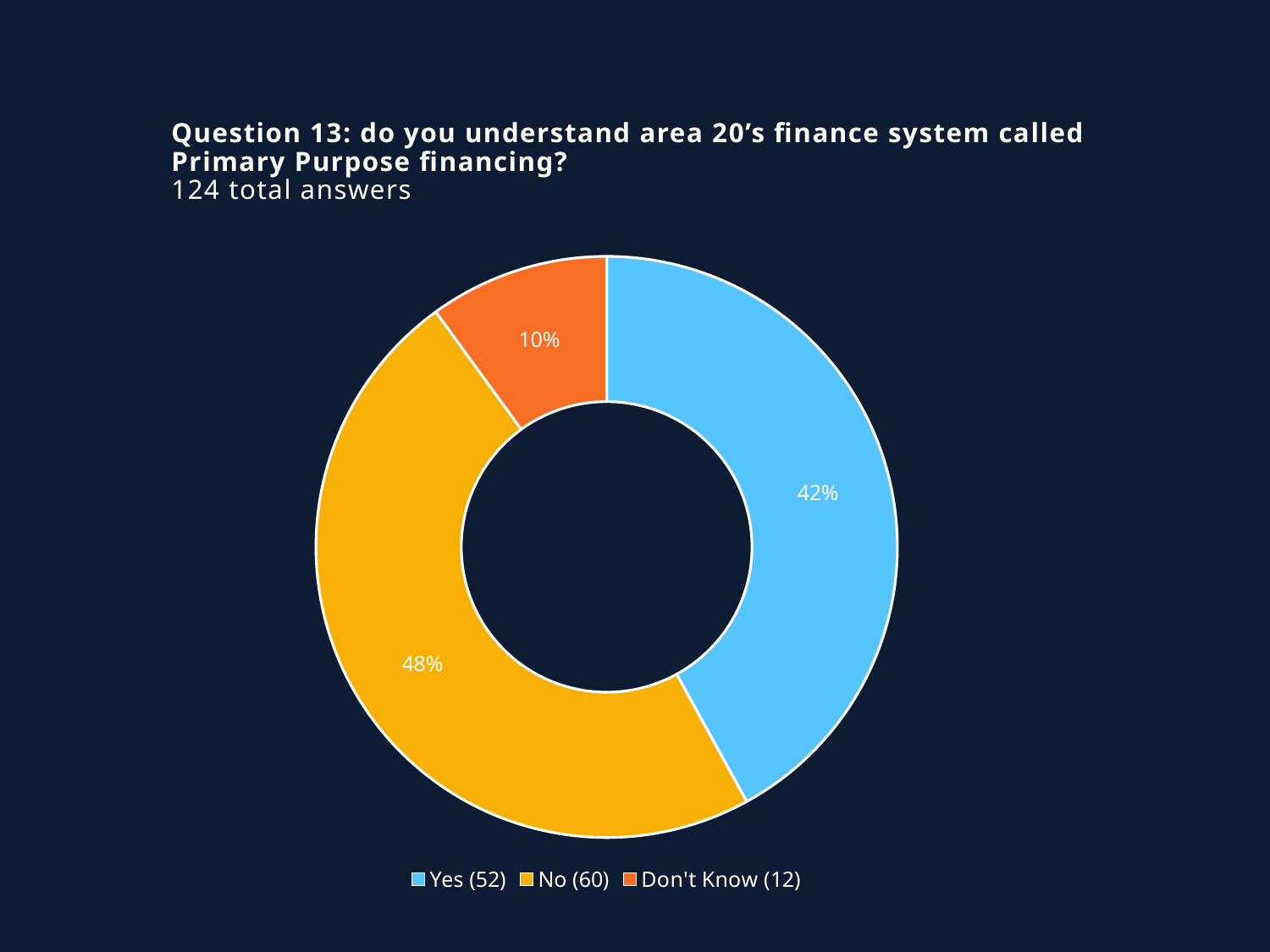
How many respondents answered "No" according to the legend? 60 What colour represents the "Don't Know" category? Orange Which answer received the smallest share of responses? Don't Know How many total answers does the slide report? 124 Which share is larger, "Yes" or "Don't Know"? Yes Which answer received the largest share of responses? No What is the difference in percentage points between the "No" and "Yes" shares? 6 What kind of chart is shown on the slide? Pie chart (doughnut) What percentage of respondents answered "Don't Know"? 10% How many answer categories does the chart show? 3 What percentage of respondents answered "No"? 48% What percentage of respondents answered "Yes"? 42%